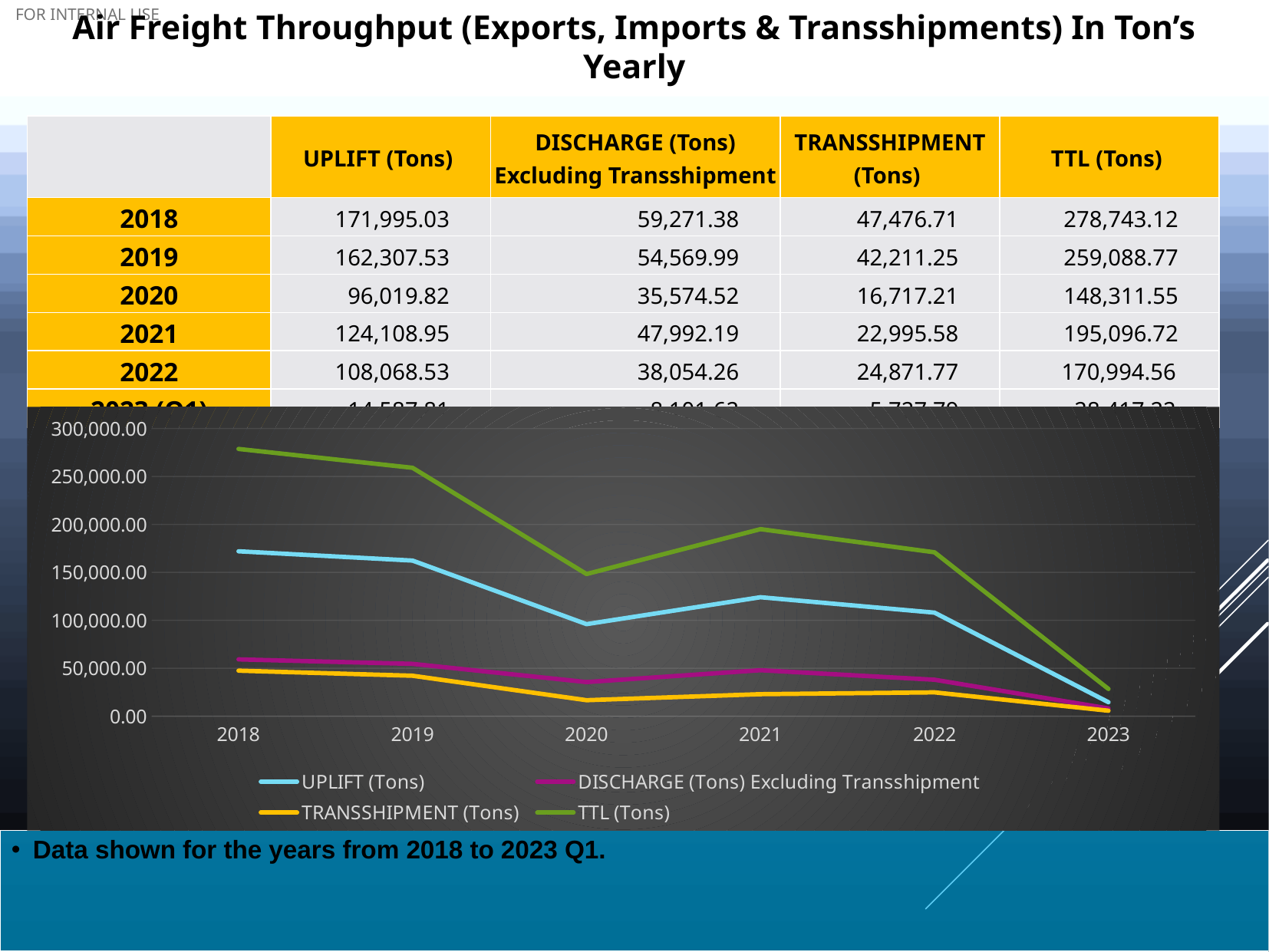
What is the TTL (Tons) value for 2020 as shown in the table? 148,311.55 How many years are shown along the x axis of the chart? 6 Is the UPLIFT (Tons) value for 2018 greater or less than 150,000.00? greater Which series is drawn in green in the chart? TTL (Tons) Is the TTL (Tons) value for 2019 greater or less than 250,000.00? greater In which year is the TTL (Tons) line at its highest? 2018 In which year is the TTL (Tons) line at its lowest? 2023 Is the TRANSSHIPMENT (Tons) value for 2020 greater or less than 50,000.00? less Does the TTL (Tons) line generally rise or fall from 2018 to 2023? fall How many series does the chart legend list? 4 What kind of chart is shown on the slide? line chart Which is larger, the UPLIFT (Tons) value for 2021 or for 2022? 2021